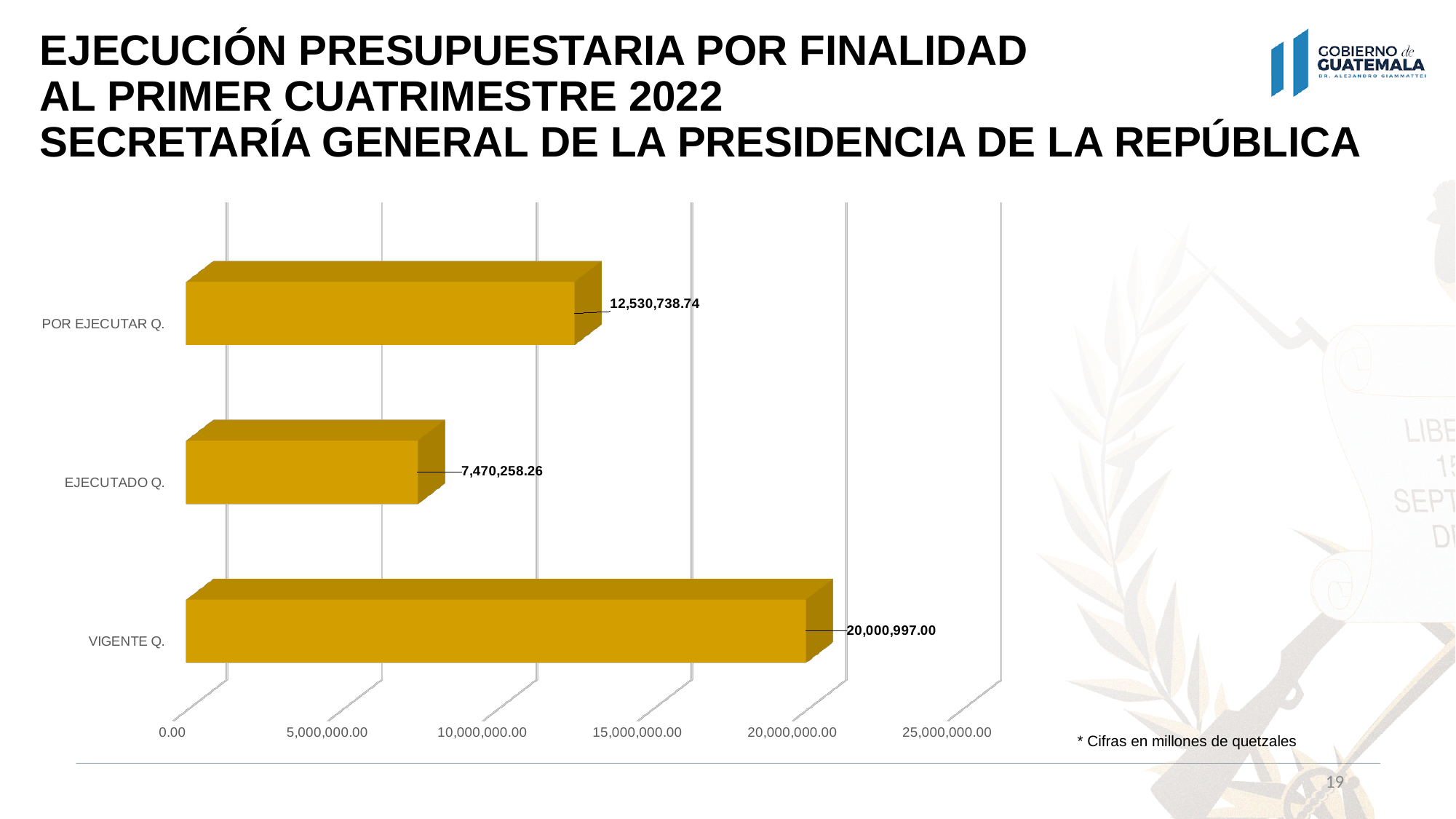
Which is larger, POR EJECUTAR Q. or EJECUTADO Q.? POR EJECUTAR Q. Which category has the highest value? VIGENTE Q. What is the value for VIGENTE Q.? 20,000,997.00 Is the value for EJECUTADO Q. greater or less than 10,000,000.00? less Which category has the lowest value? EJECUTADO Q. What is the difference between POR EJECUTAR Q. and EJECUTADO Q.? 5,060,480.48 Is the value for POR EJECUTAR Q. greater or less than 10,000,000.00? greater How many categories are shown in the chart? 3 What is the value for POR EJECUTAR Q.? 12,530,738.74 What is the difference between VIGENTE Q. and EJECUTADO Q.? 12,530,738.74 What kind of chart is shown on the slide? bar chart What is the value for EJECUTADO Q.? 7,470,258.26